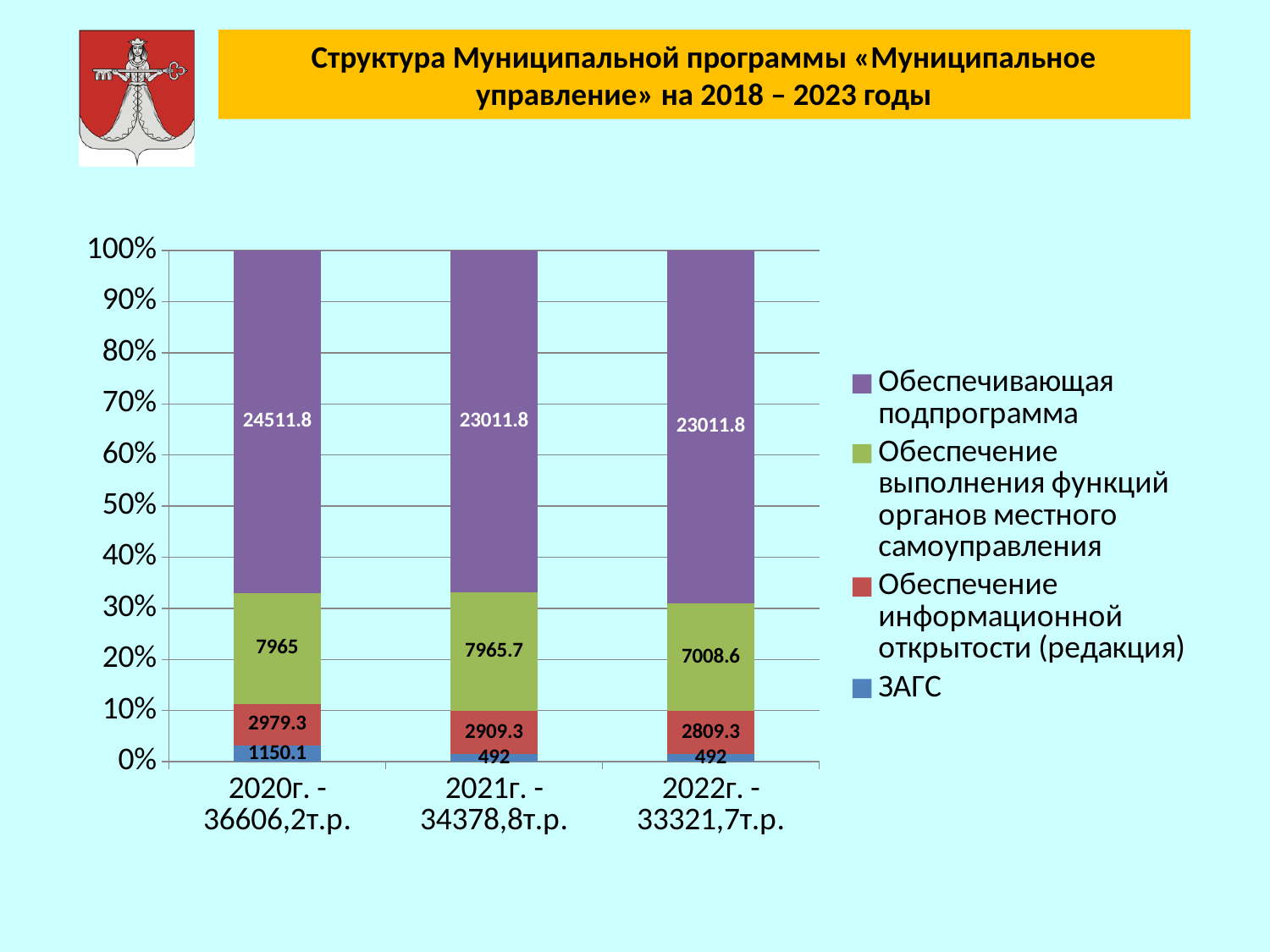
What is the value of «ЗАГС» for 2021г.? 492 Is the share of «Обеспечивающая подпрограмма» in the 2020г. bar greater or less than 60%? greater How many bars (years) are shown in the chart? 3 What kind of chart is shown on the slide? Stacked bar chart What is the value of «Обеспечение информационной открытости (редакция)» for 2020г.? 2979.3 In which year is the value of «ЗАГС» highest? 2020г. What is the difference between the «Обеспечивающая подпрограмма» values for 2020г. and 2021г.? 1500 Which is larger: «Обеспечение информационной открытости (редакция)» in 2021г. or in 2022г.? 2021г. What is the value of «Обеспечение выполнения функций органов местного самоуправления» for 2022г.? 7008.6 How many series does the legend list? 4 What is the value of «Обеспечивающая подпрограмма» for 2020г.? 24511.8 Which series is shown in purple in the legend? Обеспечивающая подпрограмма